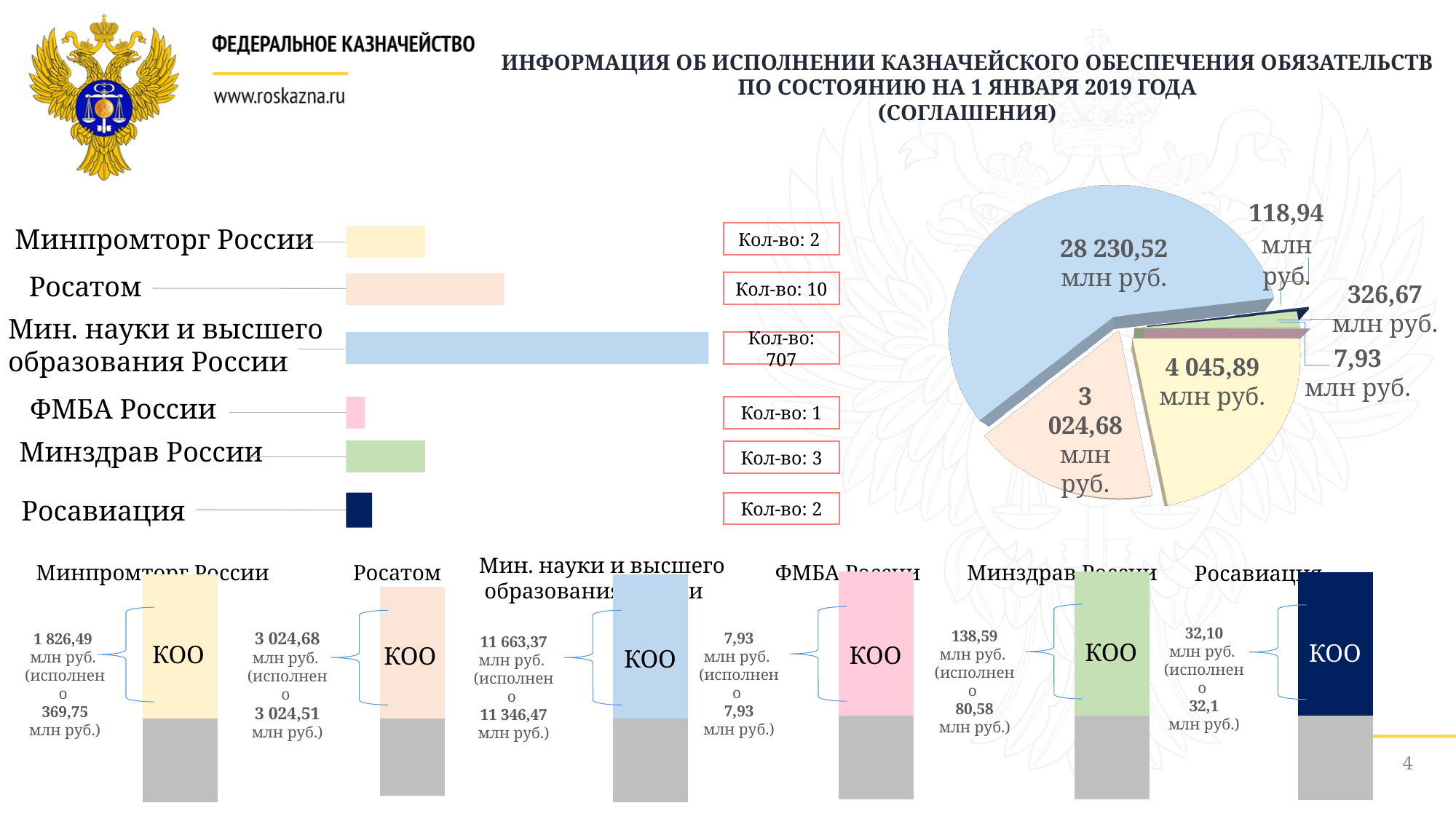
How many slices does the pie chart on the right have? 6 How many categories are shown in the horizontal bar chart on the left? 6 In the horizontal bar chart on the left, which has the larger Кол-во value: Росатом or Минпромторг России? Росатом In the pie chart on the right, what is the value of the largest slice? 28 230,52 млн руб. In the bottom chart, what is the исполнено value shown for Минздрав России? 80,58 млн руб. In the horizontal bar chart on the left, what is the Кол-во value shown for Мин. науки и высшего образования России? 707 What kind of chart is the chart on the left of the slide? bar chart In the horizontal bar chart on the left, what is the Кол-во value shown for Росатом? 10 In the horizontal bar chart on the left, which category has the longest bar? Мин. науки и высшего образования России In the horizontal bar chart on the left, which category has the shortest bar? ФМБА России In the bottom chart, what is the КОО value shown for Минпромторг России? 1 826,49 млн руб. In the bottom chart, what is the difference between the КОО value and the исполнено value for Минпромторг России? 1 456,74 млн руб.